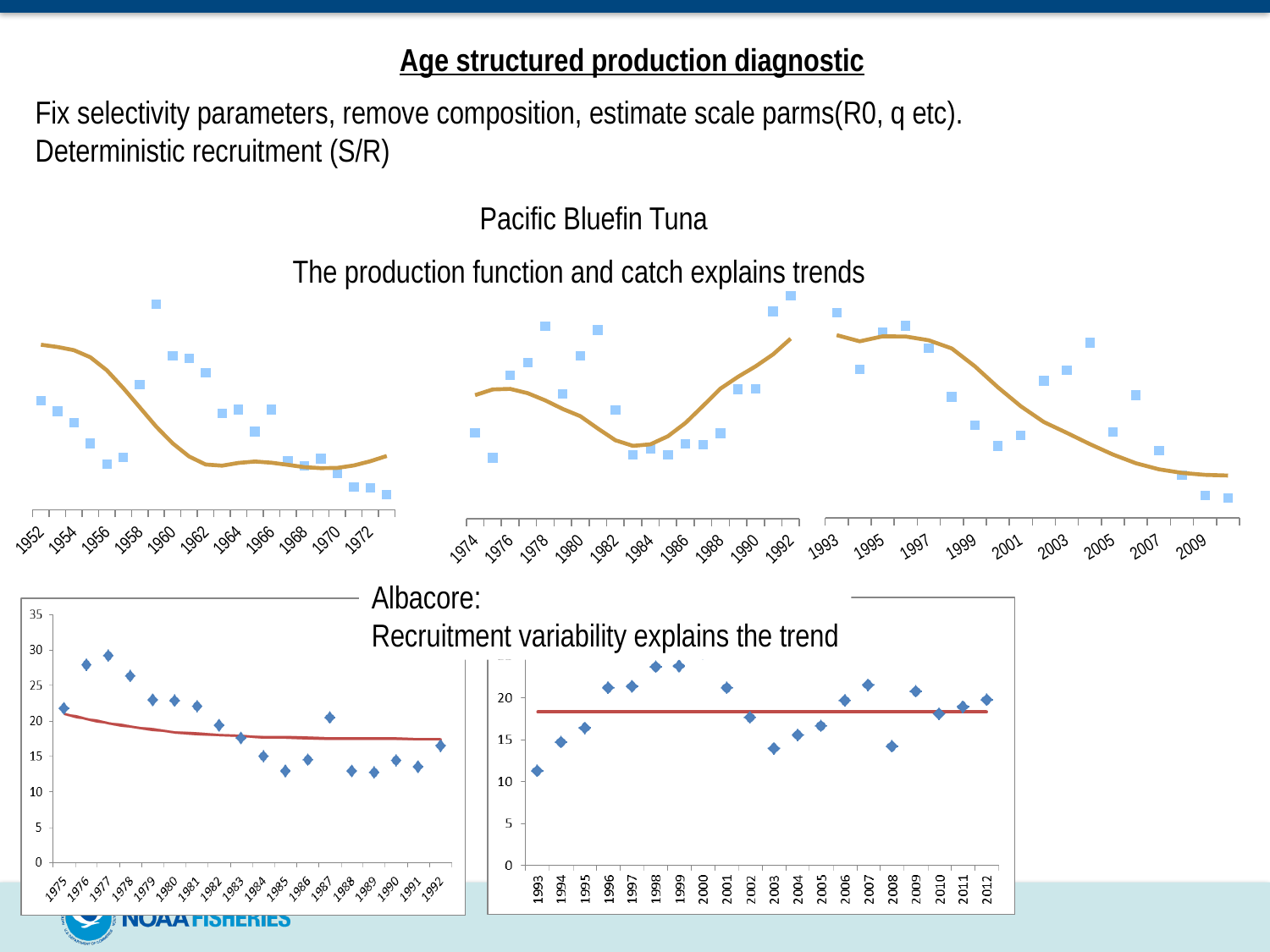
What kind of chart is the Albacore chart for 1993-2012 (bottom right)? scatter plot with a fitted line In the Albacore chart for 1975-1992 (bottom left), which year has the larger value, 1977 or 1985? 1977 In the Albacore chart for 1993-2012 (bottom right), which year has the larger value, 1993 or 1999? 1999 In the Albacore chart for 1993-2012 (bottom right), which year has the lowest plotted value? 1993 In the Albacore chart for 1975-1992 (bottom left), is the value for 1985 greater or less than 15? less How many years are labelled on the x axis of the Albacore chart for 1975-1992 (bottom left)? 18 In the Albacore chart for 1975-1992 (bottom left), is the value for 1977 greater or less than 25? greater In the Albacore chart for 1993-2012 (bottom right), is the value for 1998 greater or less than 20? greater In the Pacific Bluefin Tuna chart covering 1993-2009 (top right), does the fitted line rise or fall from left to right? fall In the Albacore chart for 1975-1992 (bottom left), which year has the highest plotted value? 1977 What colour is the fitted line in the Albacore charts at the bottom of the slide? red